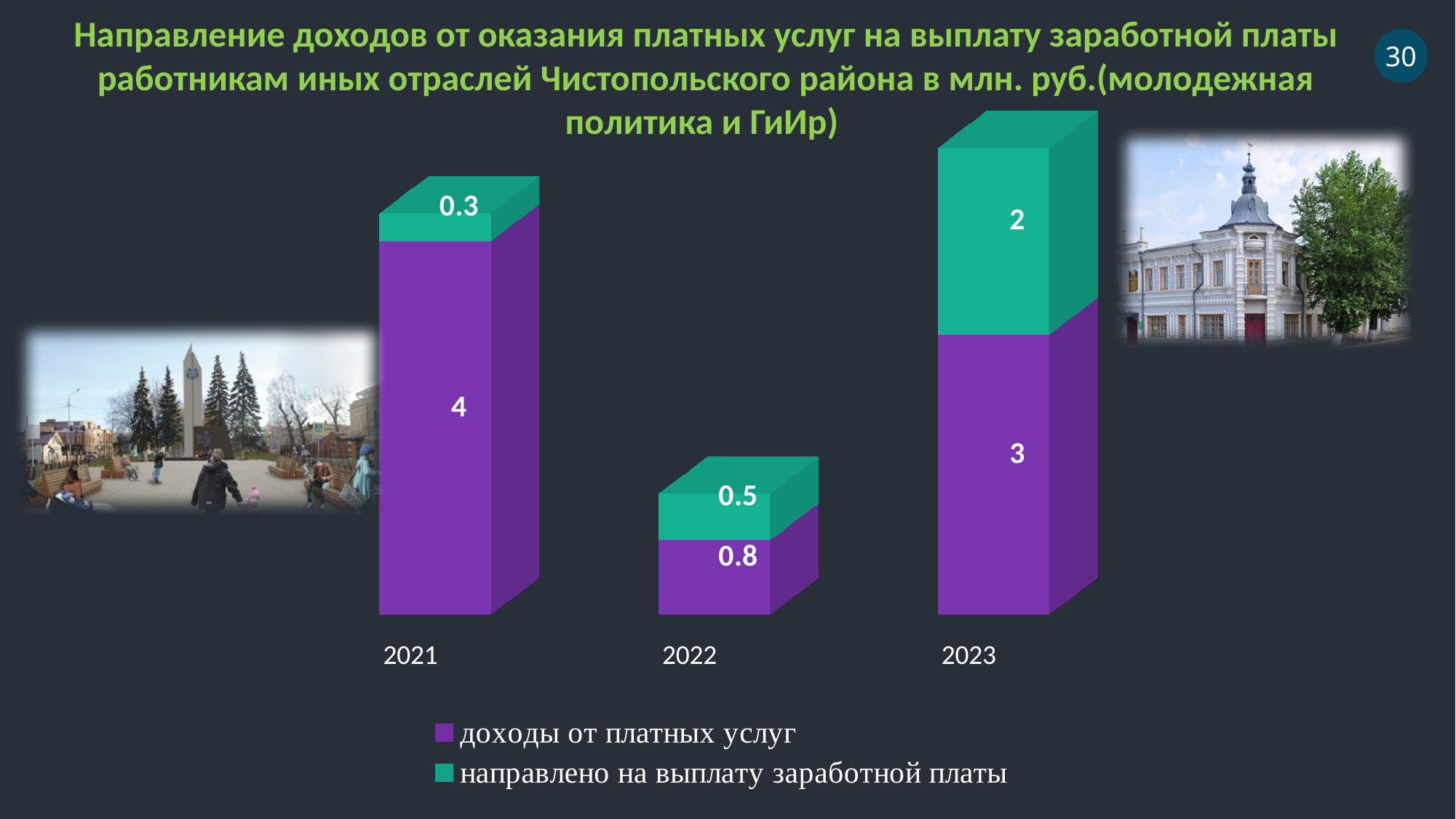
What is the difference between "доходы от платных услуг" in 2021 and 2023? 1 Which is larger: "направлено на выплату заработной платы" in 2022 or in 2023? 2023 What is the total of the stacked bar for 2023? 5 What is the value of "доходы от платных услуг" for 2022? 0.8 How many series does the legend list? 2 What is the value of "направлено на выплату заработной платы" for 2021? 0.3 Which year has the lowest value for "направлено на выплату заработной платы"? 2021 What is the value of "направлено на выплату заработной платы" for 2023? 2 What is the total of the stacked bar for 2022? 1.3 What is the value of "доходы от платных услуг" for 2021? 4 How many years are shown on the x axis? 3 Which year has the highest value for "доходы от платных услуг"? 2021